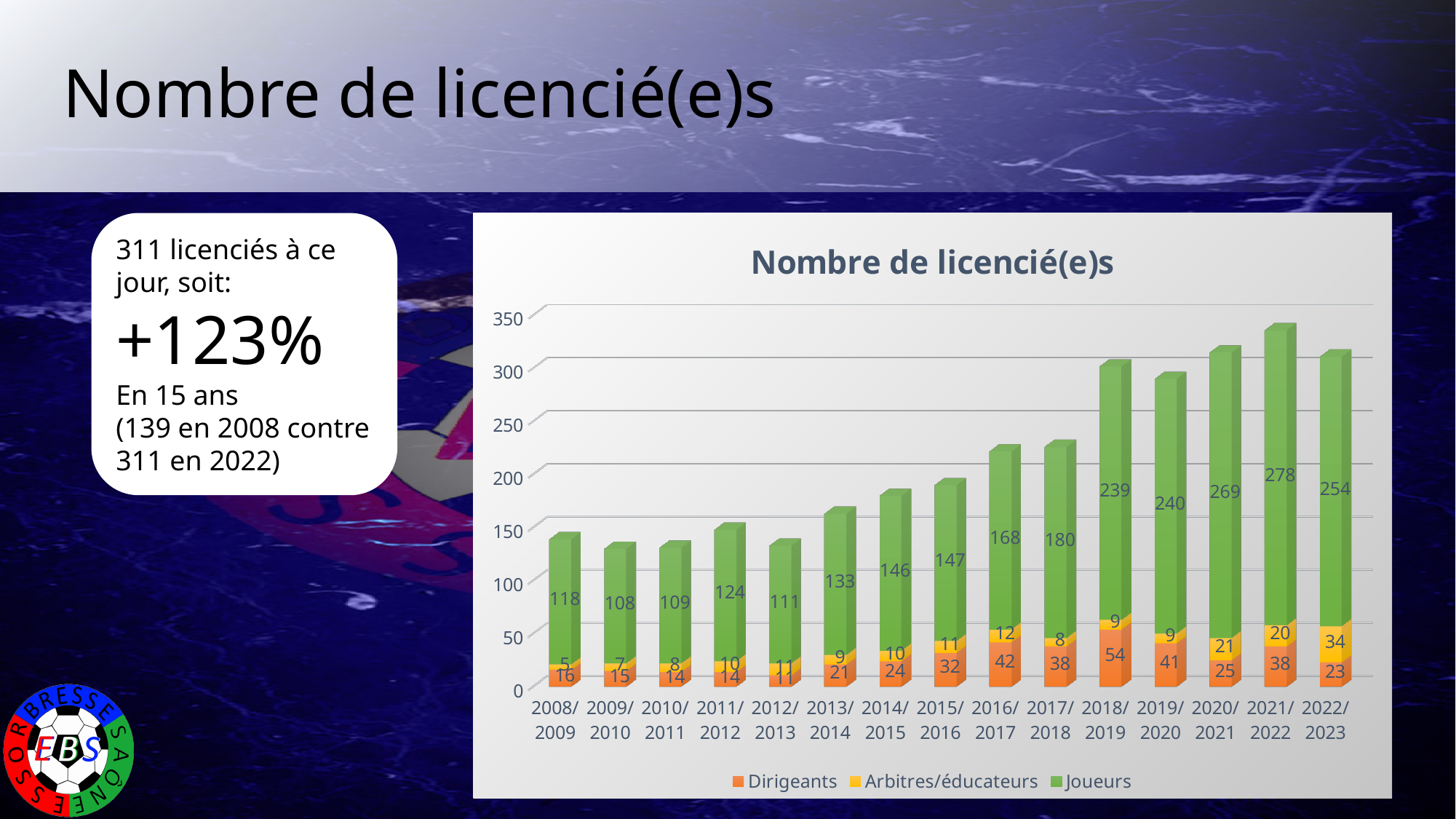
How many series does the legend list? 3 Which season has the lowest value for Arbitres/éducateurs? 2008/2009 What is the total of the stacked bar for 2022/2023? 311 What is the value for Joueurs in 2021/2022? 278 What is the value for Arbitres/éducateurs in 2022/2023? 34 What is the value for Dirigeants in 2018/2019? 54 What is the title of the chart? Nombre de licencié(e)s How many seasons are shown on the x axis? 15 What type of chart is shown on the slide? stacked bar chart Which is larger, the Dirigeants value in 2016/2017 or in 2019/2020? 2016/2017 What is the difference between the Joueurs values for 2022/2023 and 2008/2009? 136 Which season has the highest value for Joueurs? 2021/2022